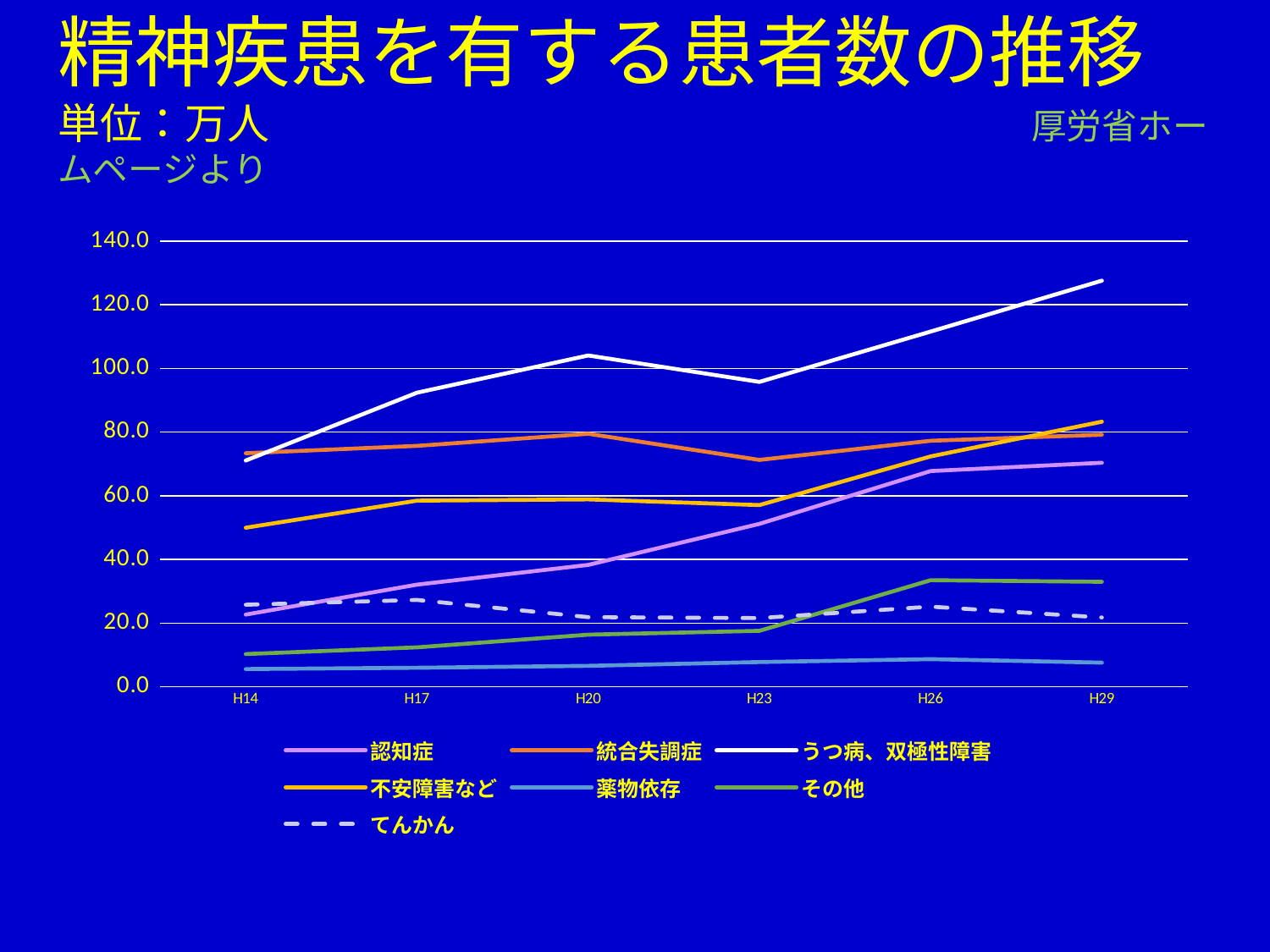
How many points are there along the x axis? 6 Is the value for 認知症 at H29 greater or less than 60.0? greater Which series is drawn with a dashed line? てんかん How many series does the legend list? 7 At H14, which is larger: 統合失調症 or 認知症? 統合失調症 What kind of chart is shown on the slide? line chart Does the value for 認知症 rise or fall from H14 to H29? rise Which series has the highest value at H29? うつ病、双極性障害 Is the value for うつ病、双極性障害 at H29 greater or less than 120.0? greater Which series has the lowest value at H29? 薬物依存 Is the value for 不安障害など at H14 greater or less than 60.0? less